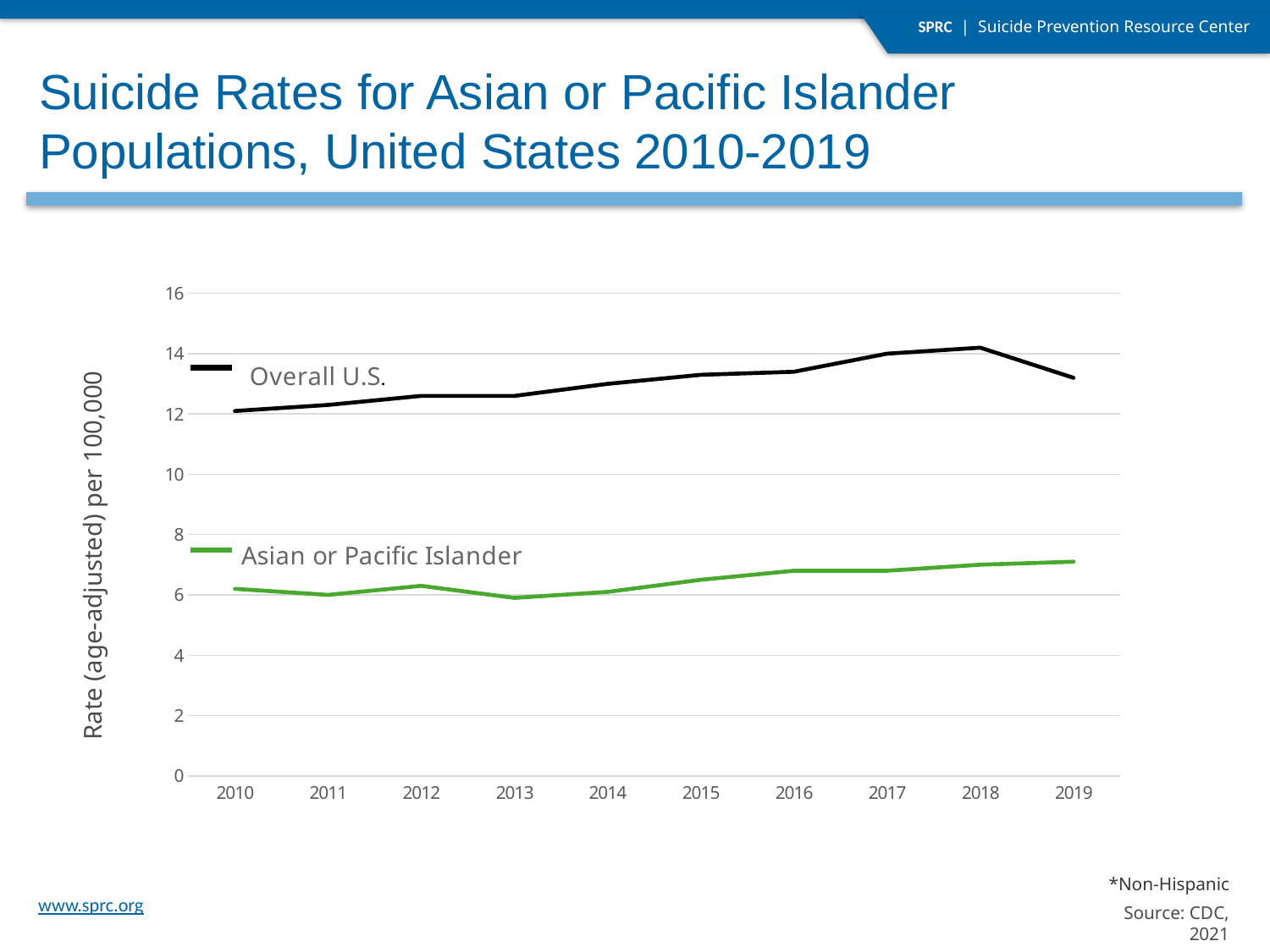
Does the Overall U.S. rate rise or fall from 2010 to 2018? Rise Is the Overall U.S. value for 2018 greater or less than 14? greater How many years are plotted along the x axis? 10 In which year is the Overall U.S. suicide rate highest? 2018 Is the Asian or Pacific Islander value for 2019 greater or less than 8? less How many series does the chart show? 2 What is the label of the y axis? Rate (age-adjusted) per 100,000 What kind of chart is shown on the slide? Line chart In which year is the Overall U.S. suicide rate lowest? 2010 Which series has the larger value in 2015, Overall U.S. or Asian or Pacific Islander? Overall U.S. In which year is the Asian or Pacific Islander suicide rate lowest? 2013